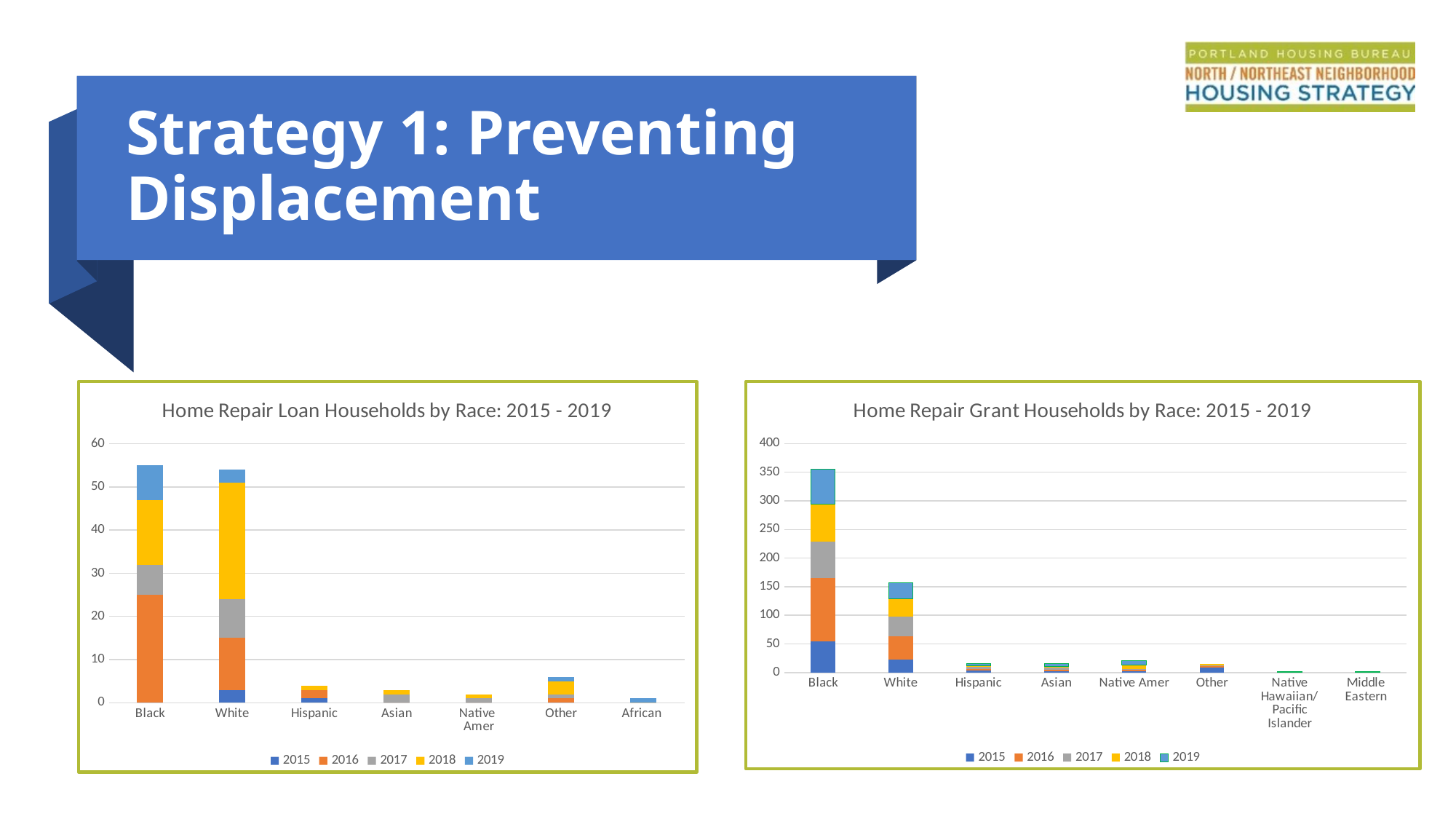
In the Home Repair Loan Households by Race chart, which category has the lowest total? African What is the title of the chart on the right side of the slide? Home Repair Grant Households by Race: 2015 - 2019 What kind of chart is the Home Repair Loan Households by Race chart on the left? stacked bar chart In the Home Repair Grant Households by Race chart, is the total for White greater or less than 200? less In the Home Repair Grant Households by Race chart, which has the larger total, Black or White? Black In the Home Repair Loan Households by Race chart, is the total for Hispanic greater or less than 10? less In the Home Repair Grant Households by Race chart, is the total for Black greater or less than 300? greater How many series does the legend of the Home Repair Loan Households by Race chart list? 5 How many race categories are shown on the x axis of the Home Repair Grant Households by Race chart? 8 In the Home Repair Grant Households by Race chart, which category has the highest total? Black How many race categories are shown on the x axis of the Home Repair Loan Households by Race chart? 7